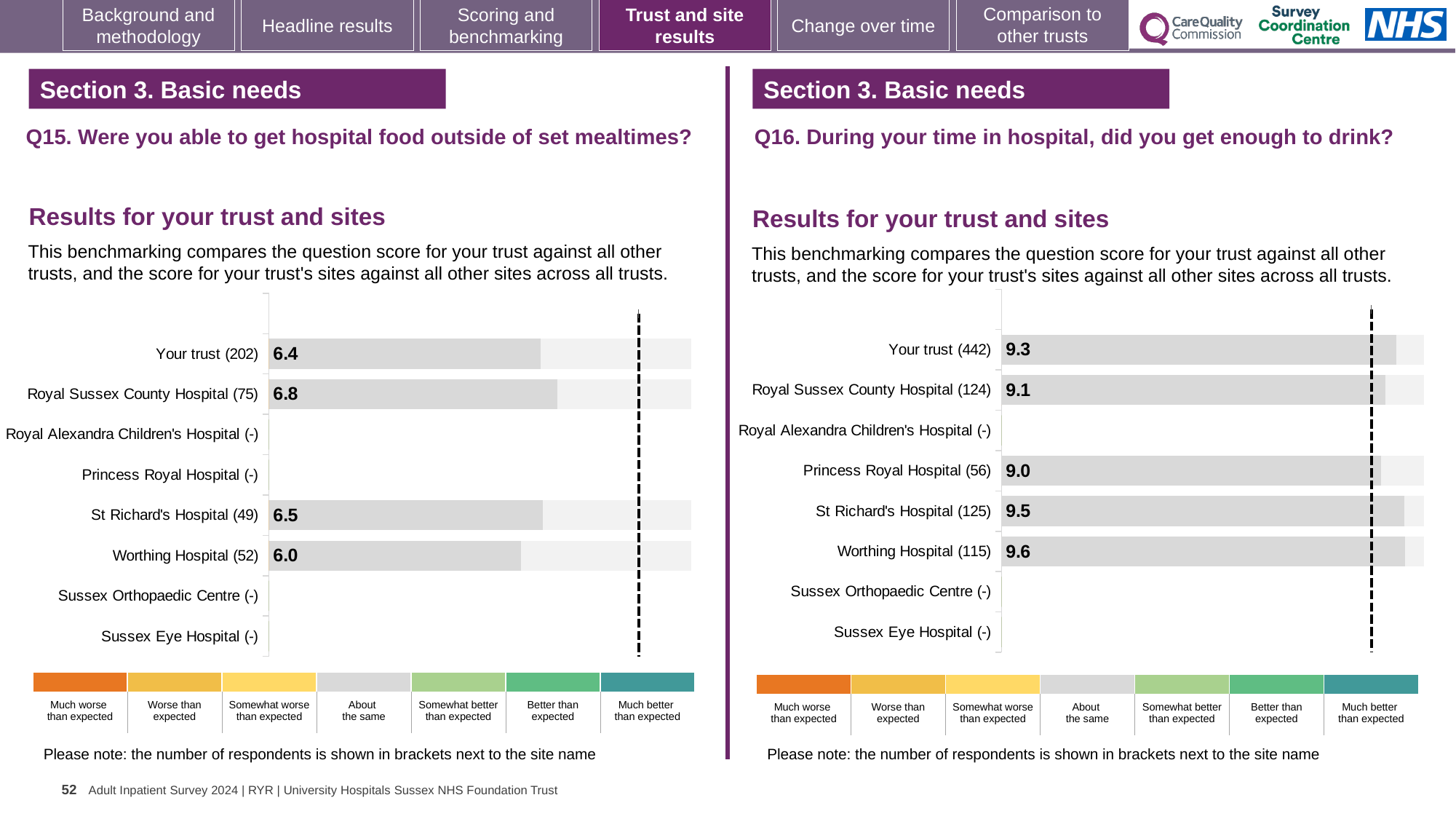
In the Q15 chart (left), how many respondents are shown for St Richard's Hospital? 49 In the Q16 chart (right), what is the score for Princess Royal Hospital? 9.0 In the Q16 chart (right), what is the difference between the scores for Worthing Hospital and Your trust? 0.3 In the Q16 chart (right), which site has the highest score? Worthing Hospital In the Q16 chart (right), how many sites have a score value displayed? 4 In the Q15 chart (left), what is the difference between the scores for Royal Sussex County Hospital and Worthing Hospital? 0.8 In the Q15 chart (left), which site has the highest score? Royal Sussex County Hospital In the Q16 chart (right), which is larger, the score for St Richard's Hospital or Royal Sussex County Hospital? St Richard's Hospital What type of chart is used on this slide? Bar chart In the Q15 chart (left), what is the score for Your trust? 6.4 In the Q16 chart (right), which site has the lowest score among those with a value shown? Princess Royal Hospital In the Q15 chart (left), what is the score for Worthing Hospital? 6.0